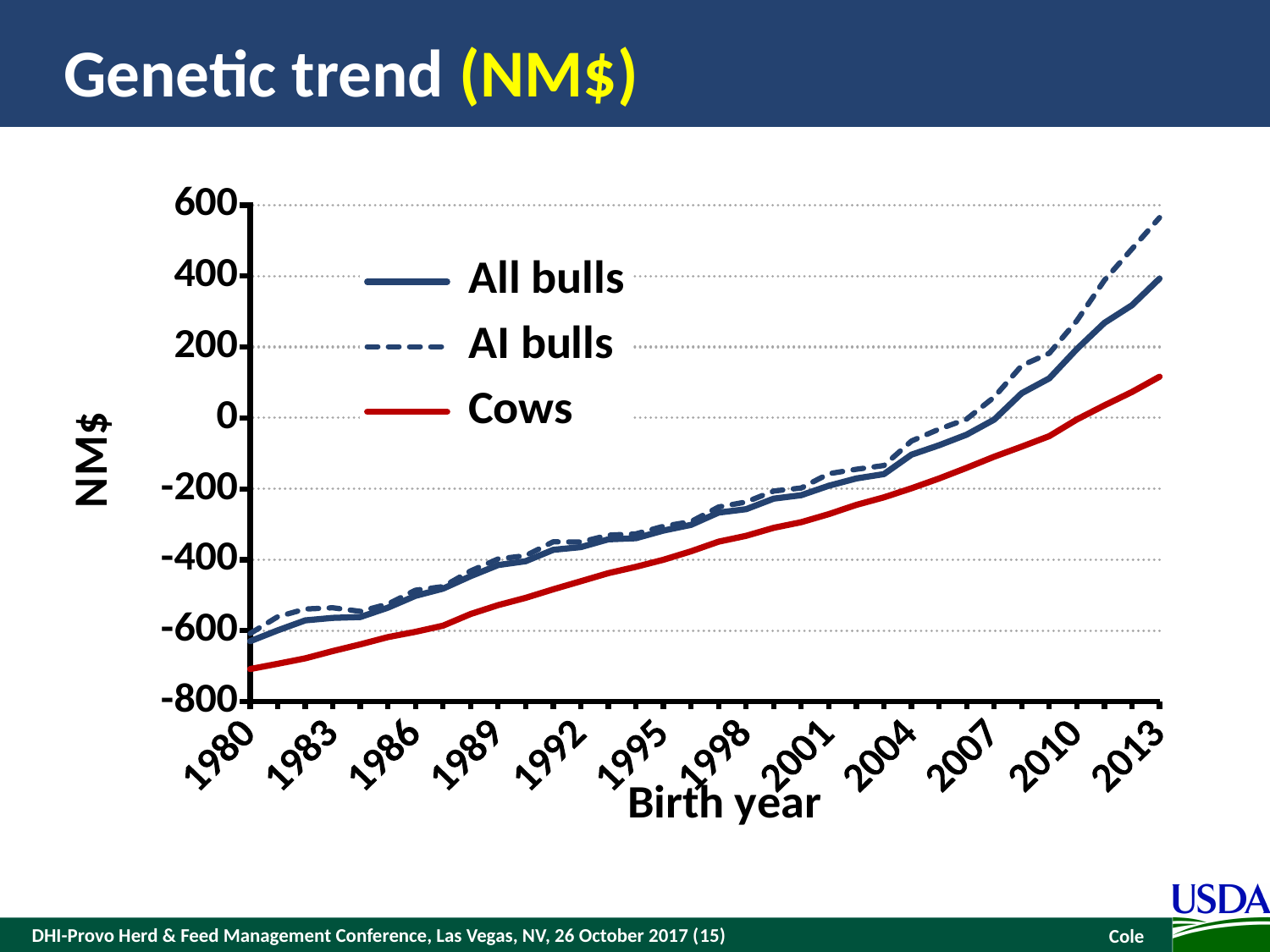
Is the NM$ value for Cows at birth year 2013 greater or less than 0? greater Which series has the highest NM$ value at birth year 2013? AI bulls Is the NM$ value for Cows at birth year 1980 greater or less than -600? less Is the NM$ value for AI bulls at birth year 2013 greater or less than 400? greater How many series does the legend list? 3 Which series is drawn with a dashed line? AI bulls Do the NM$ values for Cows rise or fall as birth year increases from 1980 to 2013? rise What kind of chart is shown on the slide? line chart What is the label of the x axis? Birth year At birth year 2013, which is larger: the NM$ value for AI bulls or for Cows? AI bulls Which series has the lowest NM$ value at birth year 1980? Cows